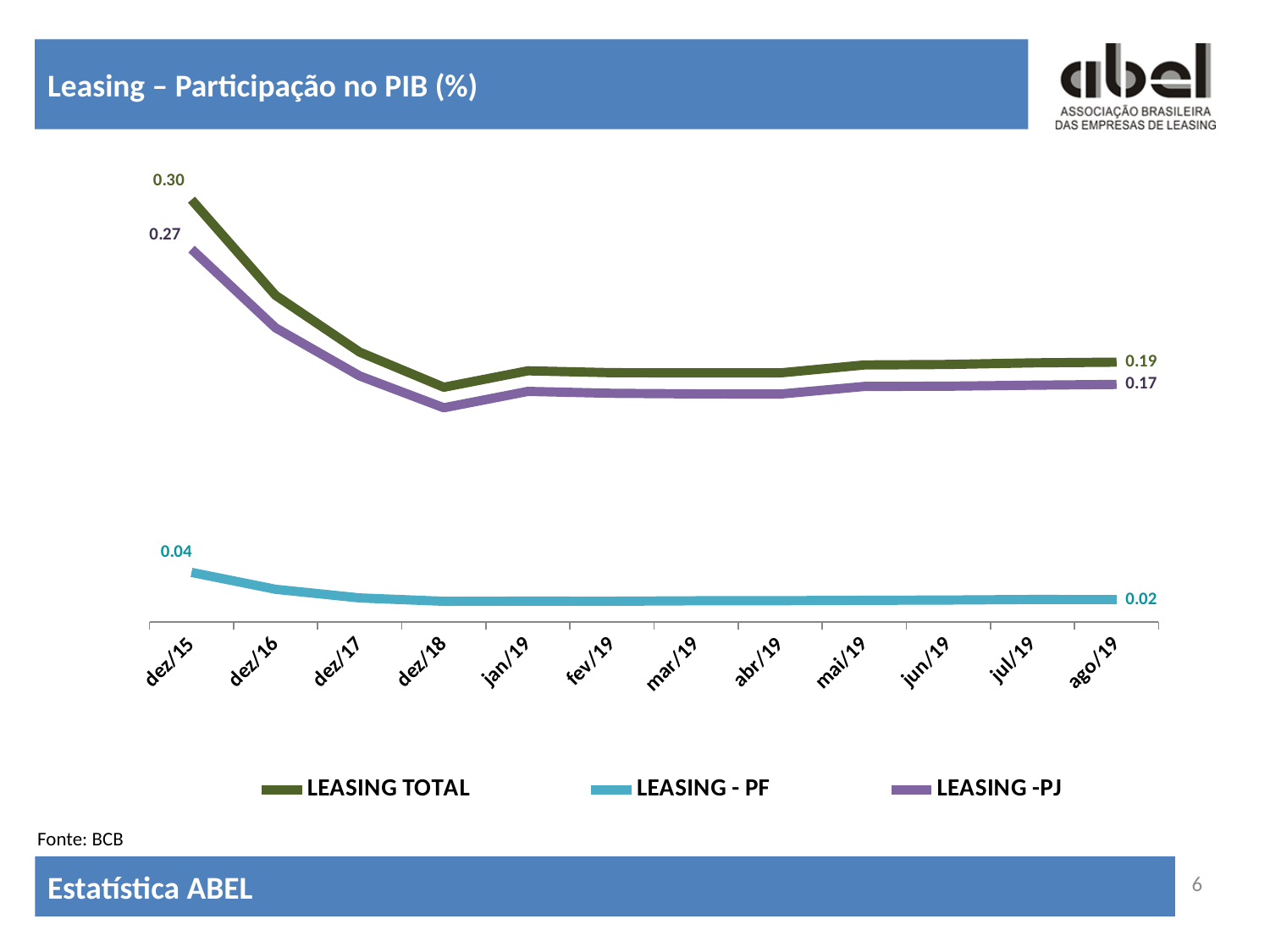
What is the difference between LEASING TOTAL and LEASING -PJ at dez/15? 0.03 What is the value of LEASING TOTAL at dez/15? 0.30 What is the value of LEASING - PF at dez/15? 0.04 What is the difference between the LEASING TOTAL value at dez/15 and at ago/19? 0.11 What is the value of LEASING TOTAL at ago/19? 0.19 What is the title of the chart? Leasing – Participação no PIB (%) Which series has the lowest values across the chart? LEASING - PF What is the value of LEASING -PJ at ago/19? 0.17 How many points are plotted along the x axis? 12 What kind of chart is shown on the slide? line chart Does the LEASING TOTAL series rise or fall from dez/15 to dez/18? fall How many series does the legend list? 3